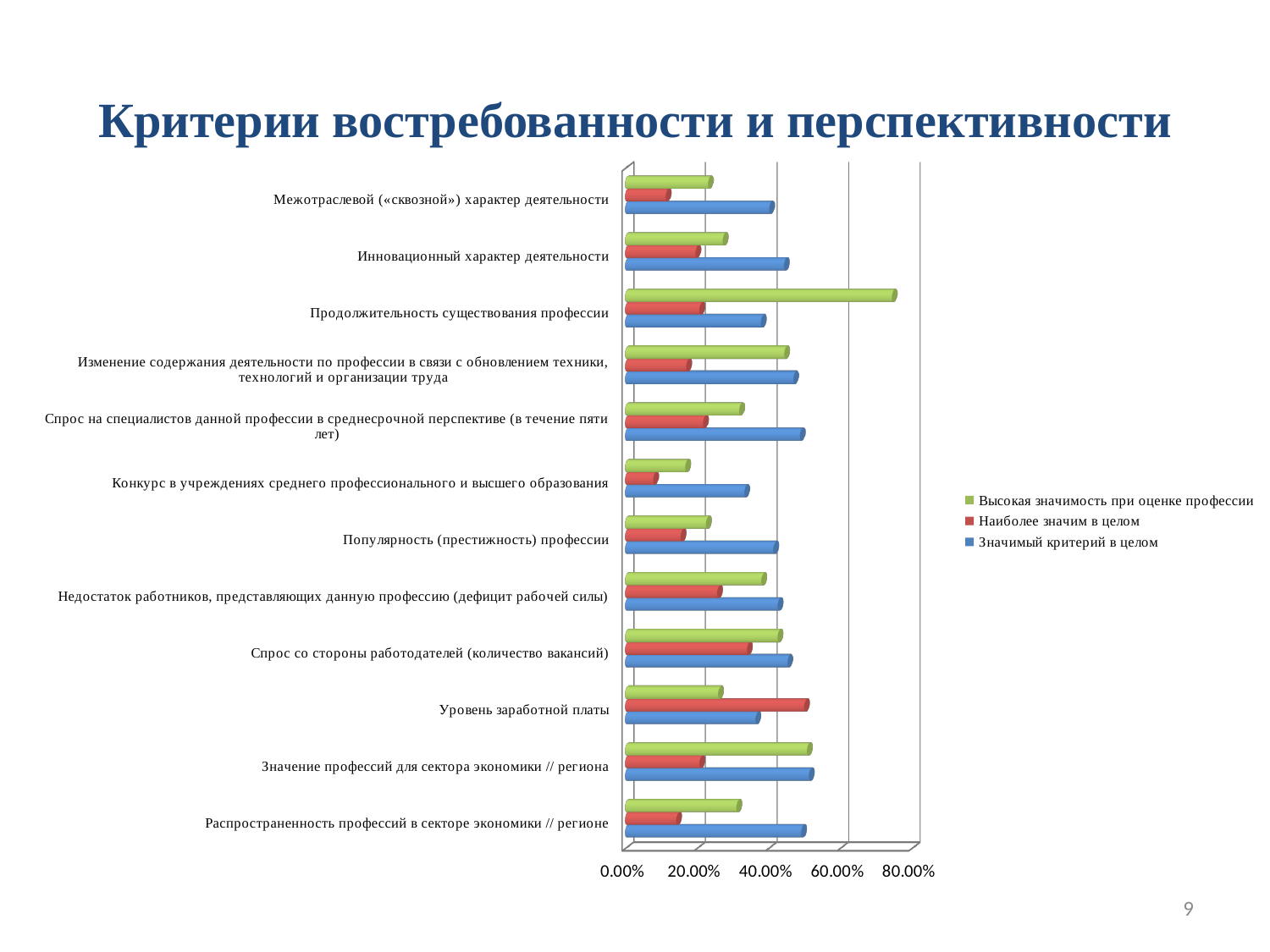
Which criterion has the highest value for the series 'Высокая значимость при оценке профессии'? Продолжительность существования профессии What kind of chart is shown on the slide? Bar chart How many criteria (categories) are listed on the chart? 12 Is the value of 'Наиболее значим в целом' for 'Уровень заработной платы' greater or less than 40.00%? greater Is the value of 'Высокая значимость при оценке профессии' for 'Продолжительность существования профессии' greater or less than 60.00%? greater How many series does the legend list? 3 Which criterion has the highest value for the series 'Наиболее значим в целом'? Уровень заработной платы What is the title of the slide? Критерии востребованности и перспективности For 'Продолжительность существования профессии', which series has the larger value: 'Высокая значимость при оценке профессии' or 'Значимый критерий в целом'? Высокая значимость при оценке профессии For 'Уровень заработной платы', which series has the larger value: 'Наиболее значим в целом' or 'Высокая значимость при оценке профессии'? Наиболее значим в целом Which criterion has the lowest value for the series 'Наиболее значим в целом'? Конкурс в учреждениях среднего профессионального и высшего образования Is the value of 'Значимый критерий в целом' for 'Конкурс в учреждениях среднего профессионального и высшего образования' greater or less than 40.00%? less